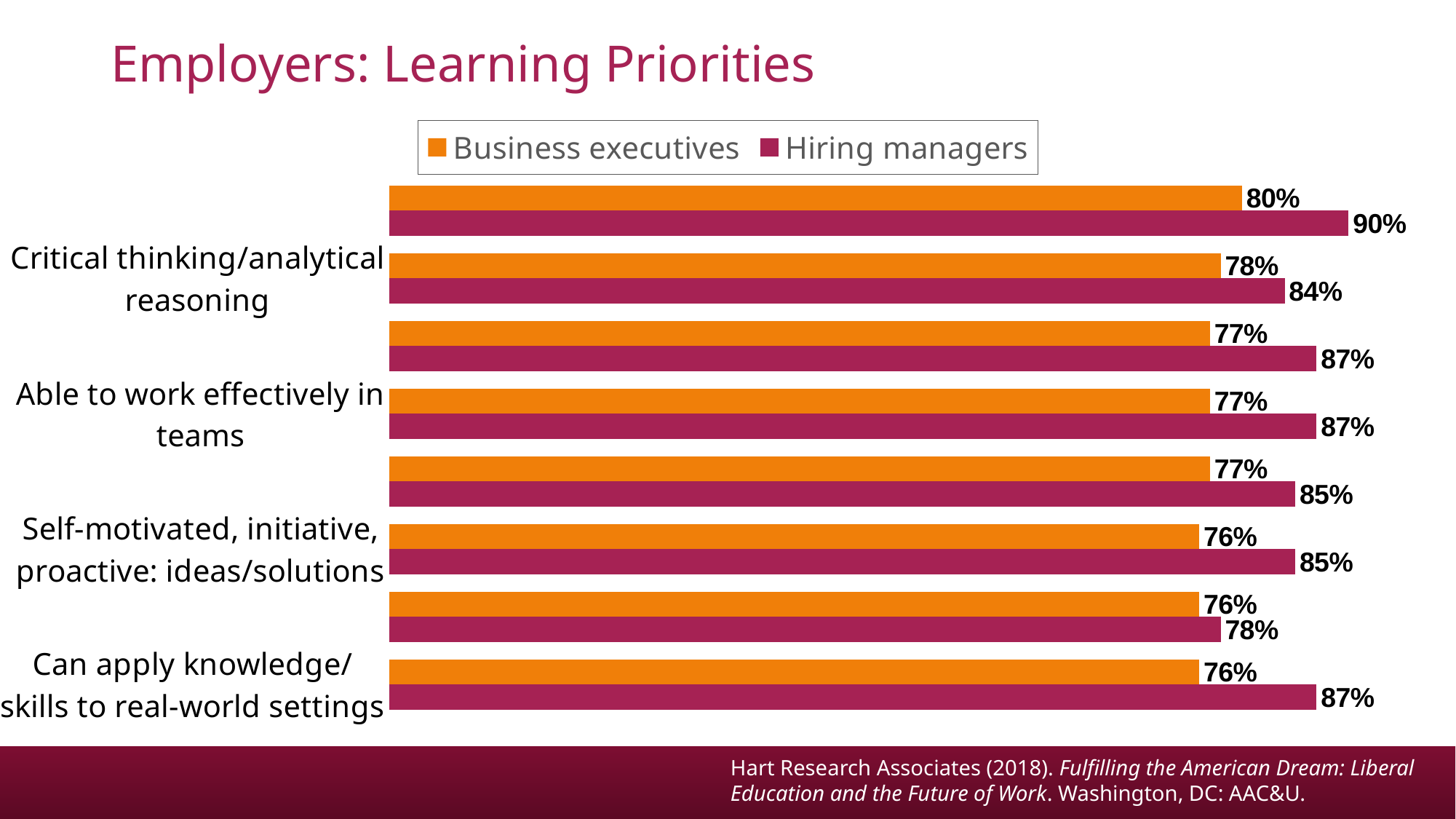
What kind of chart is shown on the slide? bar chart What is the Hiring managers value for 'Critical thinking/analytical reasoning'? 84% What are the two series named in the legend? Business executives and Hiring managers For 'Can apply knowledge/skills to real-world settings', which group has the larger value, Business executives or Hiring managers? Hiring managers What is the lowest value shown for Hiring managers? 78% In the topmost pair of bars, what is the difference between the Hiring managers value (90%) and the Business executives value (80%)? 10 percentage points Which colour represents Hiring managers in the chart? magenta/dark pink What is the Business executives value for 'Able to work effectively in teams'? 77% What is the highest value shown for Hiring managers? 90% How many pairs of bars (categories) are plotted in the chart? 8 What is the highest value shown for Business executives? 80% How many series does the legend list? 2